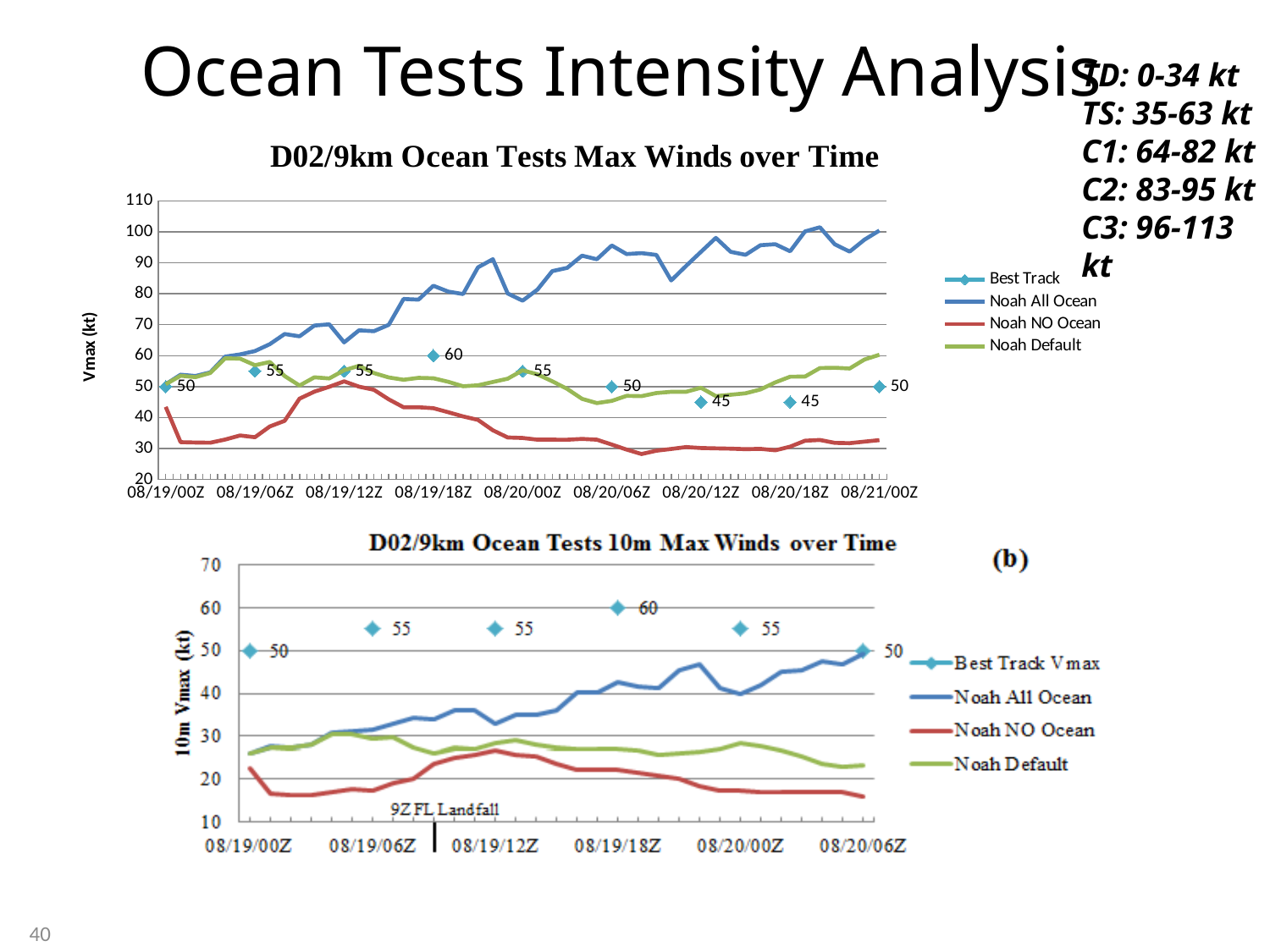
In the top chart (D02/9km Ocean Tests Max Winds over Time), is the Noah All Ocean value at 08/21/00Z greater or less than 90? greater In the top chart (D02/9km Ocean Tests Max Winds over Time), what is the highest labeled Best Track value? 60 In the bottom chart (D02/9km Ocean Tests 10m Max Winds over Time), is the Noah All Ocean value at 08/20/06Z greater or less than 40? greater In the top chart (D02/9km Ocean Tests Max Winds over Time), is the Noah NO Ocean value at 08/20/06Z greater or less than 40? less In the bottom chart (D02/9km Ocean Tests 10m Max Winds over Time), which series is higher at 08/20/00Z, Noah All Ocean or Noah NO Ocean? Noah All Ocean In the bottom chart (D02/9km Ocean Tests 10m Max Winds over Time), what is the Best Track Vmax value labeled at 08/19/18Z? 60 In the top chart (D02/9km Ocean Tests Max Winds over Time), does the Noah All Ocean line generally rise or fall from 08/19/00Z to 08/21/00Z? rise What kind of chart is the top chart (D02/9km Ocean Tests Max Winds over Time)? line chart In the top chart (D02/9km Ocean Tests Max Winds over Time), what is the difference between the highest and lowest labeled Best Track values? 15 In the top chart (D02/9km Ocean Tests Max Winds over Time), what is the lowest labeled Best Track value? 45 In the top chart (D02/9km Ocean Tests Max Winds over Time), what is the Best Track value labeled at 08/19/18Z? 60 How many series does the legend of the top chart (D02/9km Ocean Tests Max Winds over Time) list? 4